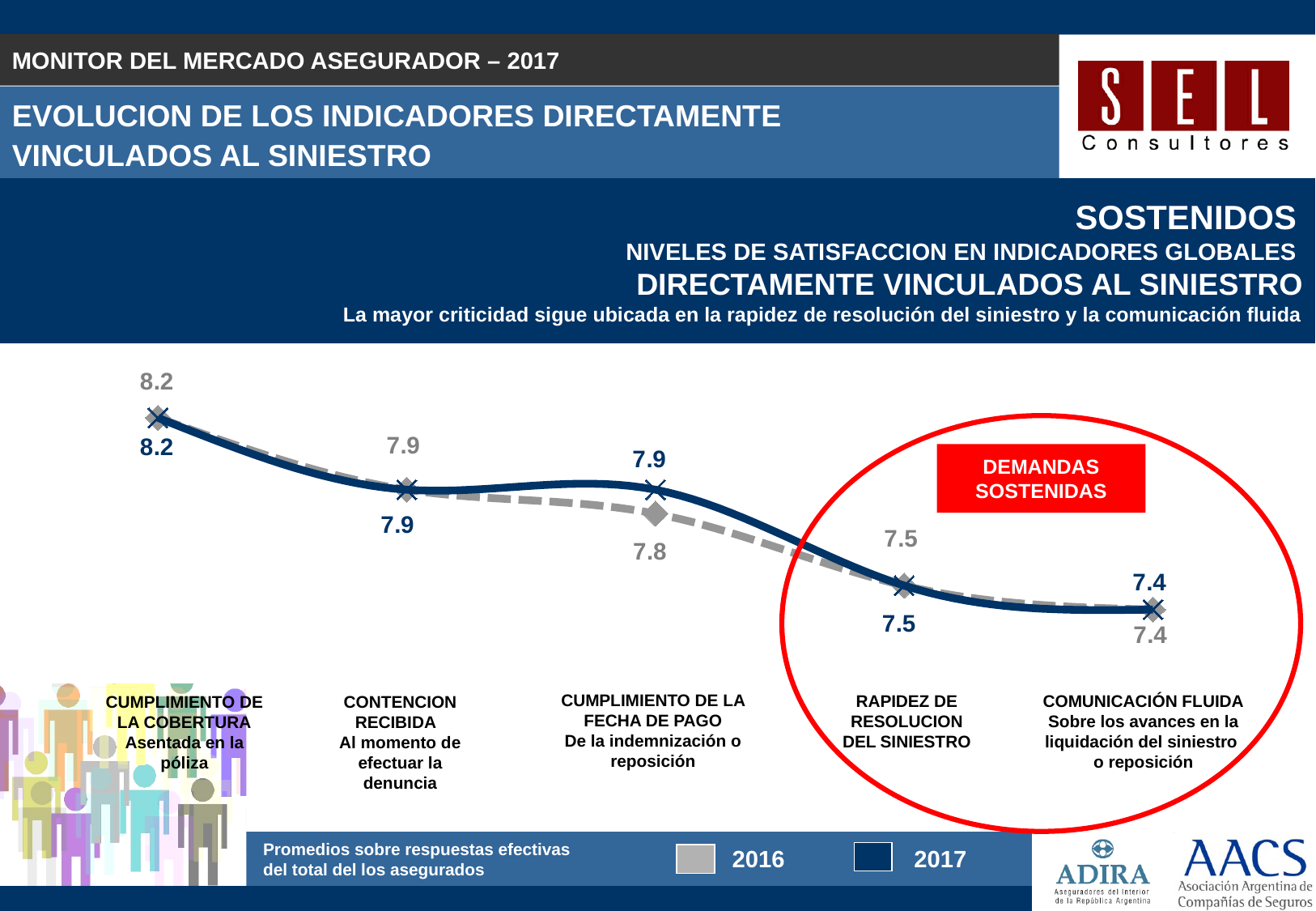
Do the 2017 values generally rise or fall from left to right across the categories? fall What is the 2017 value for Cumplimiento de la fecha de pago? 7.9 What is the 2016 value for Cumplimiento de la fecha de pago? 7.8 What is the difference between the 2017 and 2016 values for Cumplimiento de la fecha de pago? 0.1 What is the difference between the 2017 values for Cumplimiento de la cobertura and Comunicación fluida? 0.8 How many categories are plotted on the chart? 5 Which category has the highest 2017 value? Cumplimiento de la cobertura How many series does the legend list? 2 What is the 2017 value for Cumplimiento de la cobertura? 8.2 Which category has the lowest 2016 value? Comunicación fluida What is the 2017 value for Comunicación fluida? 7.4 What is the 2016 value for Rapidez de resolución del siniestro? 7.5